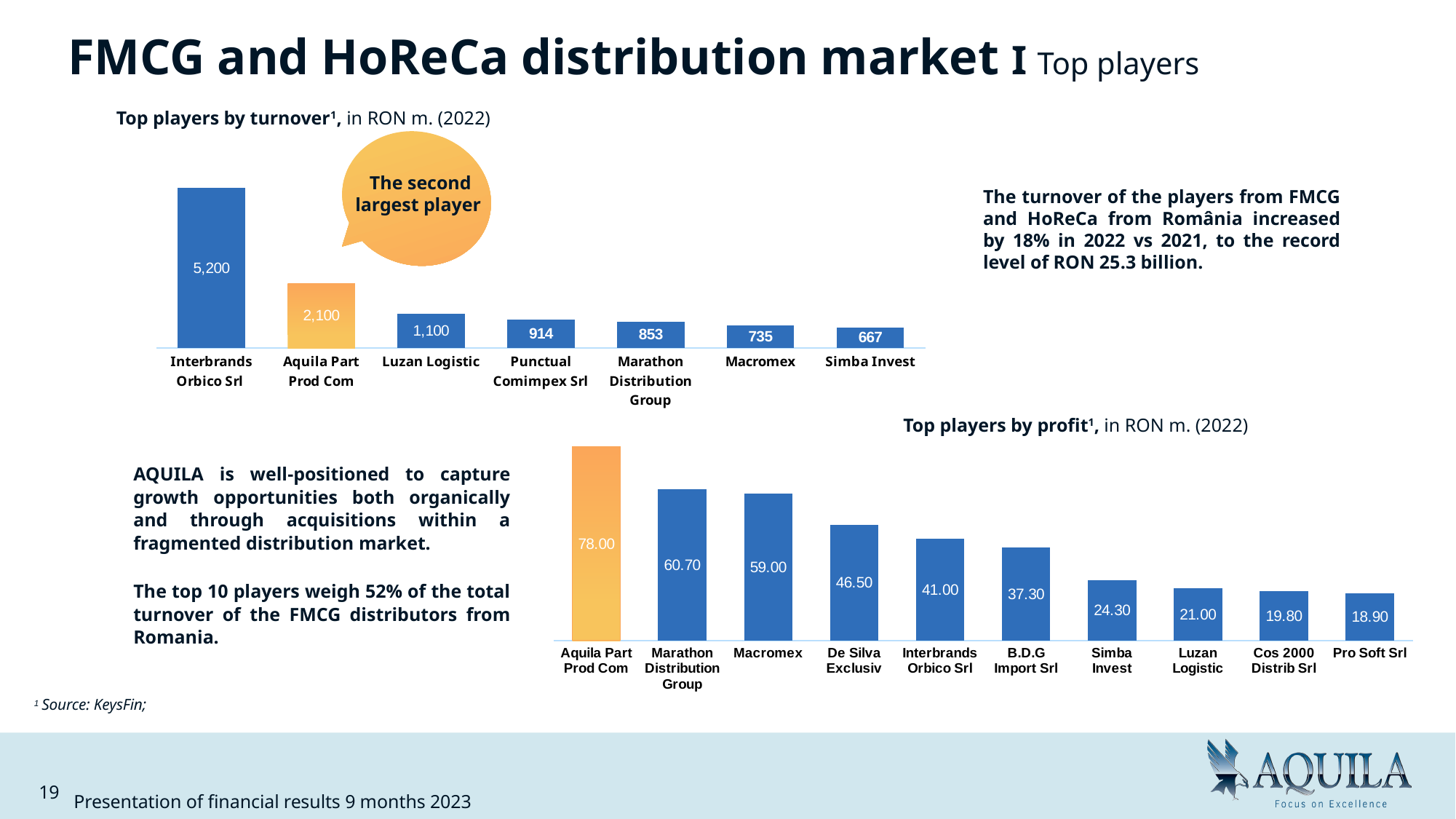
In the 'Top players by profit' chart, which company has the highest profit? Aquila Part Prod Com In the 'Top players by profit' chart, what is the value for Marathon Distribution Group? 60.70 In the 'Top players by turnover' chart, which company has the lowest turnover? Simba Invest In the 'Top players by turnover' chart, which is larger, Punctual Comimpex Srl or Macromex? Punctual Comimpex Srl What type of chart is the 'Top players by profit' chart? Bar chart In the 'Top players by turnover' chart, what is the difference between Interbrands Orbico Srl and Aquila Part Prod Com? 3,100 In the 'Top players by turnover' chart, how many companies are shown? 7 In the 'Top players by profit' chart, which company has the lowest profit? Pro Soft Srl In the 'Top players by profit' chart, what is the difference between Aquila Part Prod Com and Macromex? 19.00 In the 'Top players by turnover' chart, what is the value for Interbrands Orbico Srl? 5,200 In the 'Top players by profit' chart, how many companies are shown? 10 In the 'Top players by turnover' chart, what is the value for Aquila Part Prod Com? 2,100